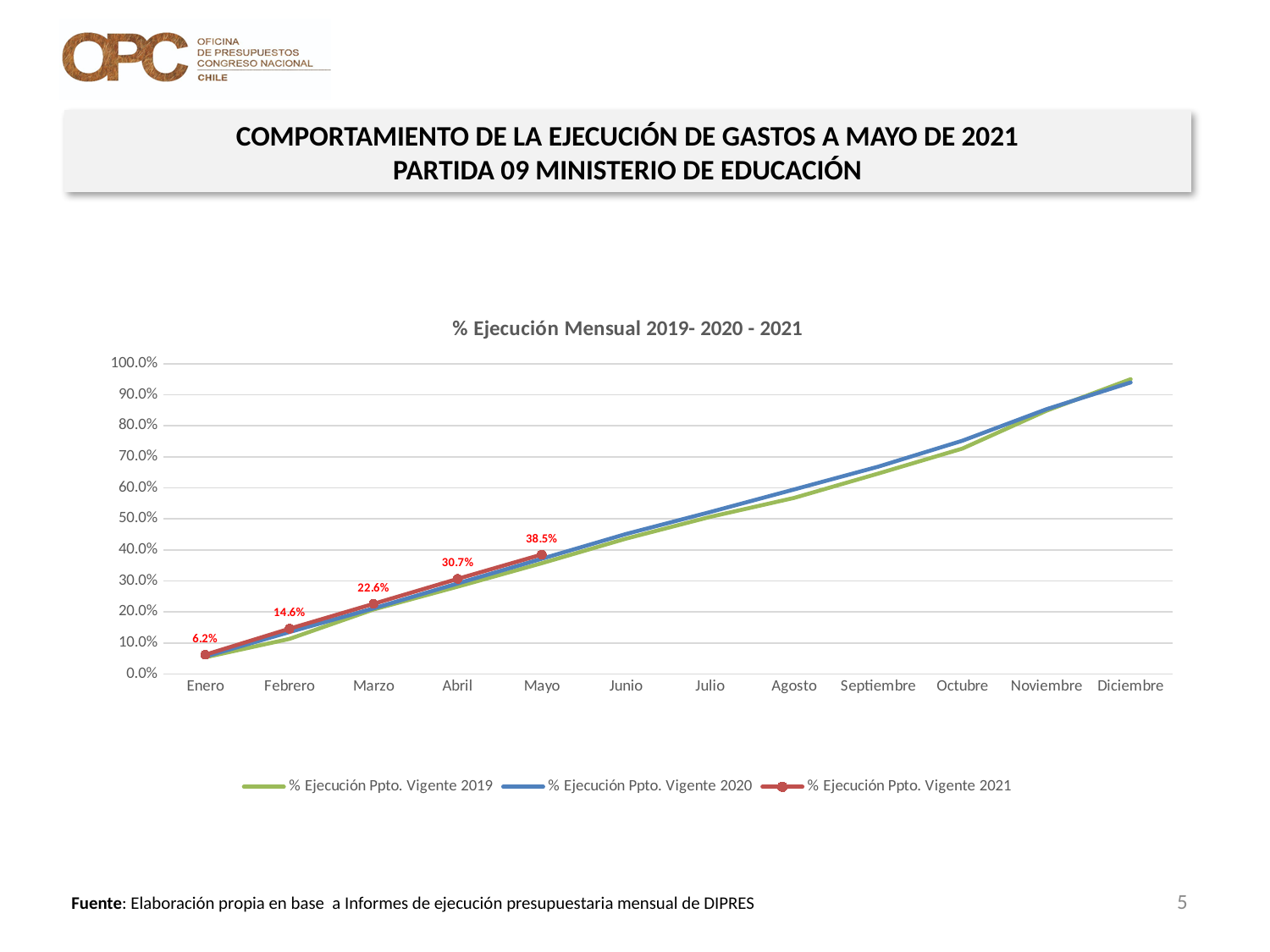
What is the title of the chart? % Ejecución Mensual 2019- 2020 - 2021 What is the difference between the Mayo and Abril values in the % Ejecución Ppto. Vigente 2021 series? 7.8 percentage points What is the value for Abril in the % Ejecución Ppto. Vigente 2021 series? 30.7% How many months are shown on the x axis of the chart? 12 What is the value for Marzo in the % Ejecución Ppto. Vigente 2021 series? 22.6% Which month has the highest labelled value in the % Ejecución Ppto. Vigente 2021 series? Mayo How many series does the legend list? 3 What is the value for Enero in the % Ejecución Ppto. Vigente 2021 series? 6.2% What is the value for Mayo in the % Ejecución Ppto. Vigente 2021 series? 38.5% Do the values in the % Ejecución Ppto. Vigente 2020 series rise or fall from Enero to Diciembre? Rise Is the value for Octubre in the % Ejecución Ppto. Vigente 2019 series greater or less than 80.0%? less What kind of chart is shown on the slide? Line chart